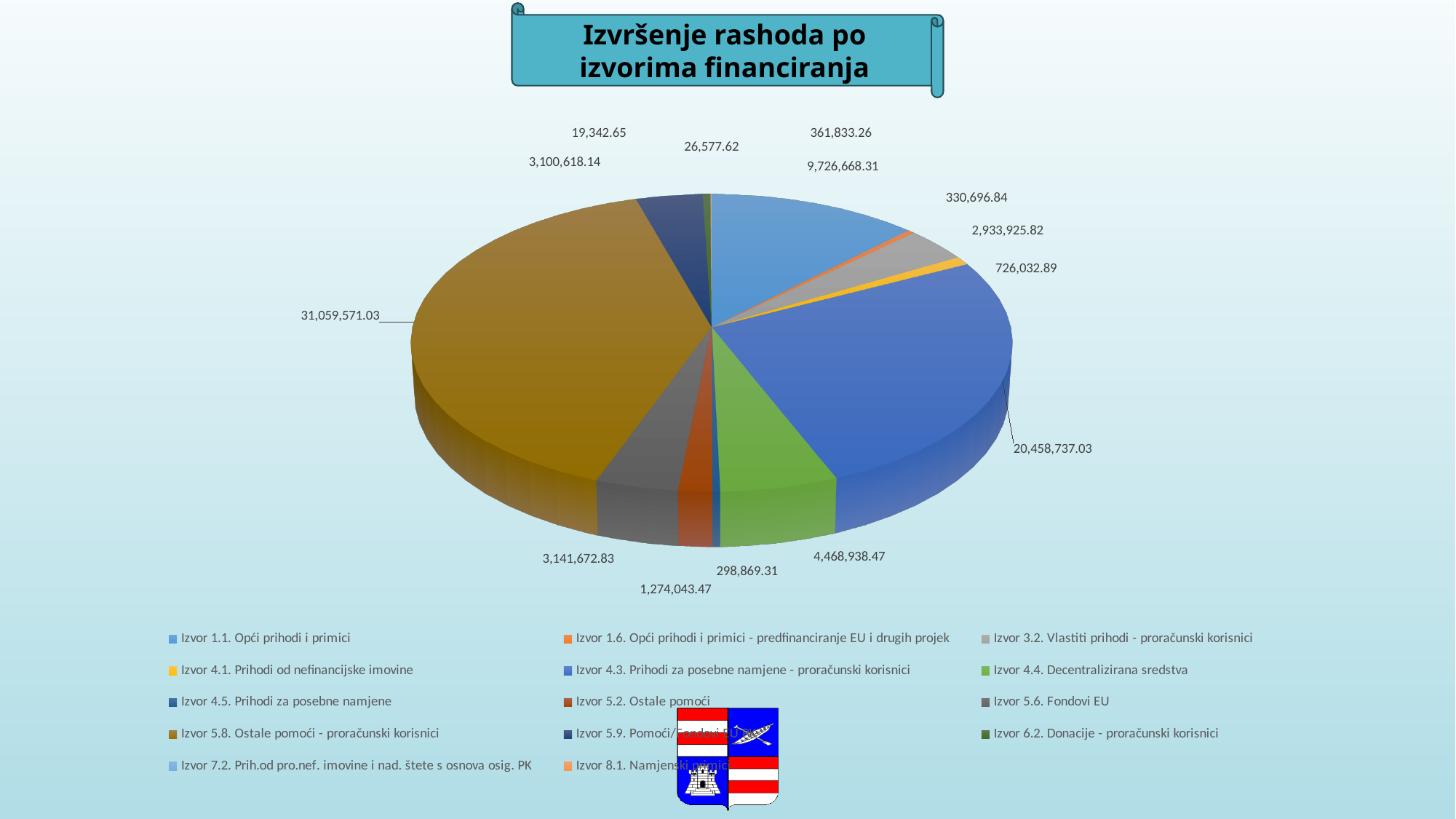
What is the value for Izvor 5.6. Fondovi EU? 3,141,672.83 What is the smallest data label value shown on the chart? 19,342.65 What is the value for Izvor 1.1. Opći prihodi i primici? 9,726,668.31 What is the value for Izvor 4.4. Decentralizirana sredstva? 4,468,938.47 What is the difference between the values for Izvor 5.8. Ostale pomoći - proračunski korisnici and Izvor 4.3. Prihodi za posebne namjene - proračunski korisnici? 10,600,834.00 How many entries does the legend list? 14 What is the value for Izvor 4.3. Prihodi za posebne namjene - proračunski korisnici? 20,458,737.03 What is the title of the chart? Izvršenje rashoda po izvorima financiranja Which source has the largest slice of the pie? Izvor 5.8. Ostale pomoći - proračunski korisnici What is the value for Izvor 5.8. Ostale pomoći - proračunski korisnici? 31,059,571.03 What kind of chart is shown on the slide? pie chart Which is larger, Izvor 4.3. Prihodi za posebne namjene - proračunski korisnici or Izvor 1.1. Opći prihodi i primici? Izvor 4.3. Prihodi za posebne namjene - proračunski korisnici